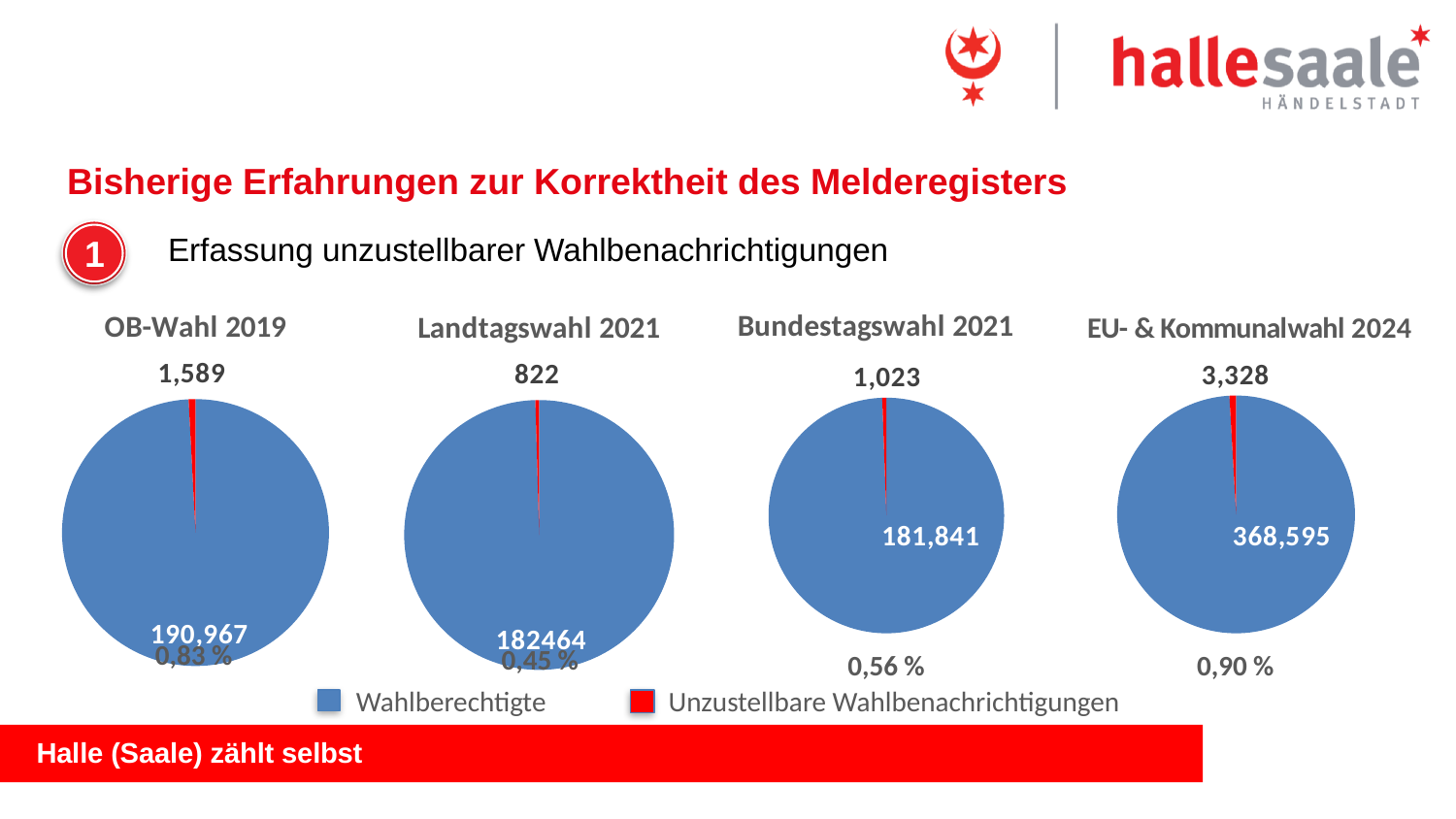
In the EU- & Kommunalwahl 2024 chart, which slice is larger, Wahlberechtigte or Unzustellbare Wahlbenachrichtigungen? Wahlberechtigte In the Landtagswahl 2021 chart, what share of the pie do the Unzustellbare Wahlbenachrichtigungen make up, as printed on the slide? 0,45 % In the OB-Wahl 2019 chart, what is the value for Unzustellbare Wahlbenachrichtigungen? 1,589 In the EU- & Kommunalwahl 2024 chart, what share of the pie do the Unzustellbare Wahlbenachrichtigungen make up, as printed on the slide? 0,90 % In the Bundestagswahl 2021 chart, what is the value for Unzustellbare Wahlbenachrichtigungen? 1,023 How many series does the legend list for the charts? 2 How many pie charts are shown on the slide? 4 In the EU- & Kommunalwahl 2024 chart, what is the value for Wahlberechtigte? 368,595 In the OB-Wahl 2019 chart, what is the value for Wahlberechtigte? 190,967 What kind of chart is used for Bundestagswahl 2021? Pie chart In the Landtagswahl 2021 chart, what is the value for Wahlberechtigte? 182464 Which colour represents Unzustellbare Wahlbenachrichtigungen in the charts? Red